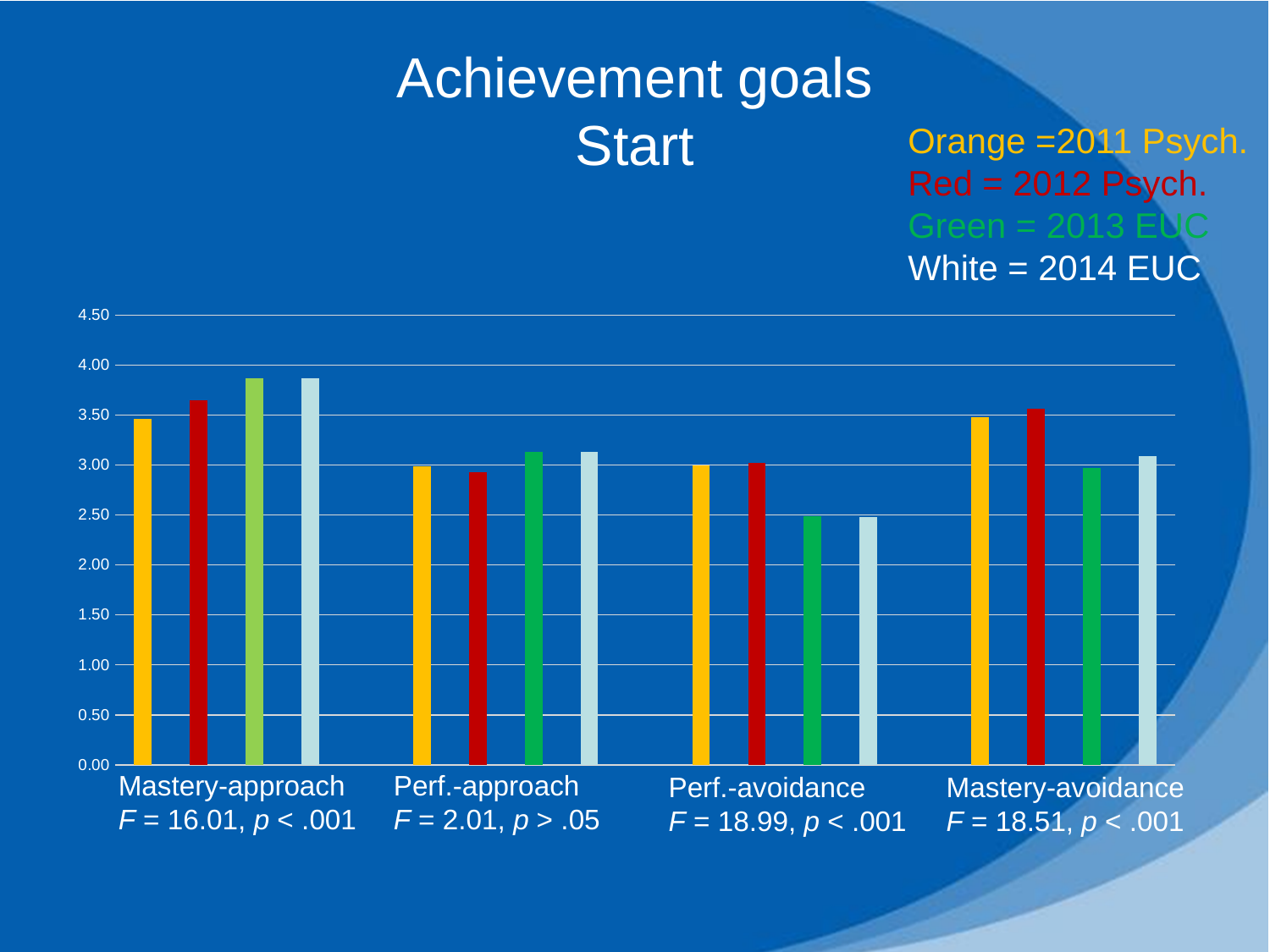
Is the value for 2013 EUC (green) in Perf.-avoidance greater or less than 3.00? less In Perf.-avoidance, which is larger: the 2011 Psych. (orange) bar or the 2013 EUC (green) bar? 2011 Psych. (orange) How many achievement-goal categories are shown on the x axis? 4 What kind of chart is shown on the slide? bar chart In Mastery-approach, which is larger: the 2011 Psych. (orange) bar or the 2013 EUC (green) bar? 2013 EUC (green) Is the value for 2012 Psych. (red) in Perf.-approach greater or less than 3.50? less For the 2013 EUC (green) series, which category has the highest value? Mastery-approach Which colour represents the 2014 EUC cohort? White For the 2013 EUC (green) series, which category has the lowest value? Perf.-avoidance How many series (cohorts) does the colour key list? 4 Is the value for 2012 Psych. (red) in Mastery-avoidance greater or less than 3.00? greater